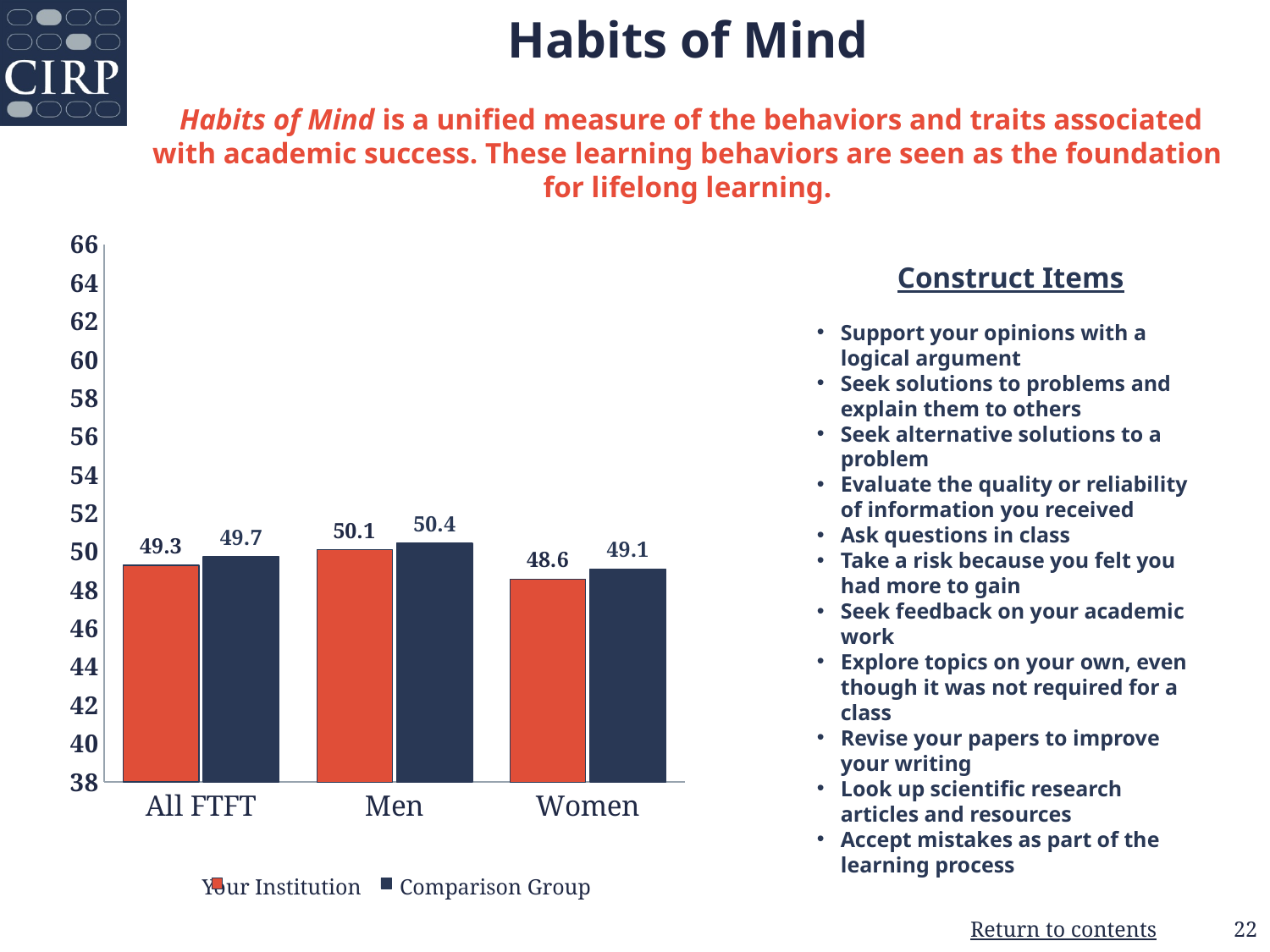
What is the difference between the Comparison Group and Your Institution values for All FTFT? 0.4 Which is larger for Women: Your Institution or Comparison Group? Comparison Group What is the Comparison Group value for Women? 49.1 What are the two series named in the legend? Your Institution and Comparison Group What is the Your Institution value for All FTFT? 49.3 Which category has the highest Comparison Group value? Men What is the difference between the Your Institution values for Men and Women? 1.5 How many categories are shown on the x axis? 3 What is the Your Institution value for Men? 50.1 How many series does the legend list? 2 What kind of chart is shown on the slide? bar chart Which category has the lowest Your Institution value? Women